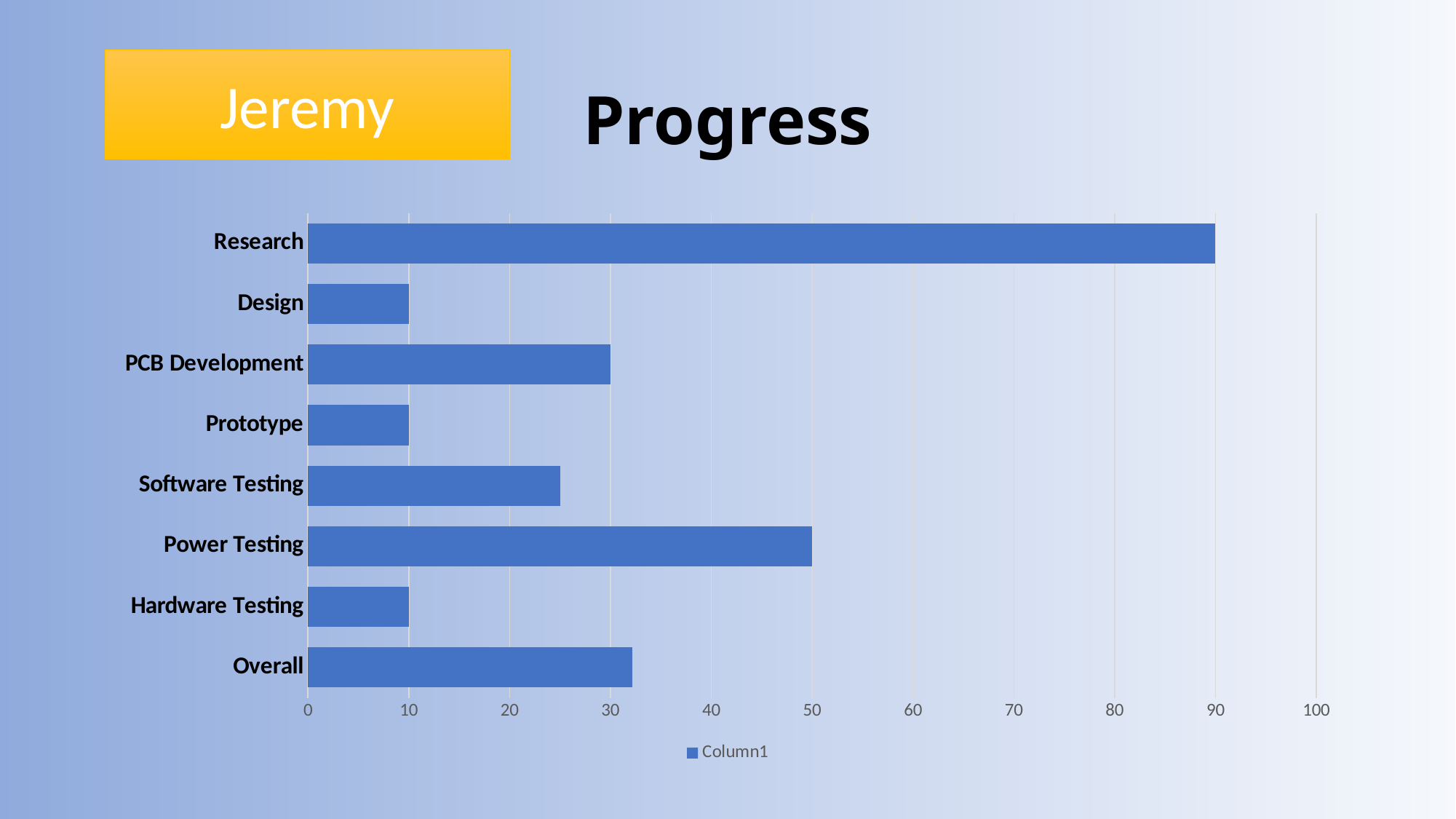
What is the value for Research? 90 Which is larger, the value for Power Testing or the value for PCB Development? Power Testing What is the value for PCB Development? 30 What is the value for Power Testing? 50 What kind of chart is shown on the slide? bar chart Is the value for Software Testing greater or less than 30? less Which category has the highest value? Research Is the value for Overall greater or less than 30? greater How many series does the legend list? 1 What is the value for Design? 10 How many categories are shown on the chart? 8 What is the difference between the values for Research and Power Testing? 40